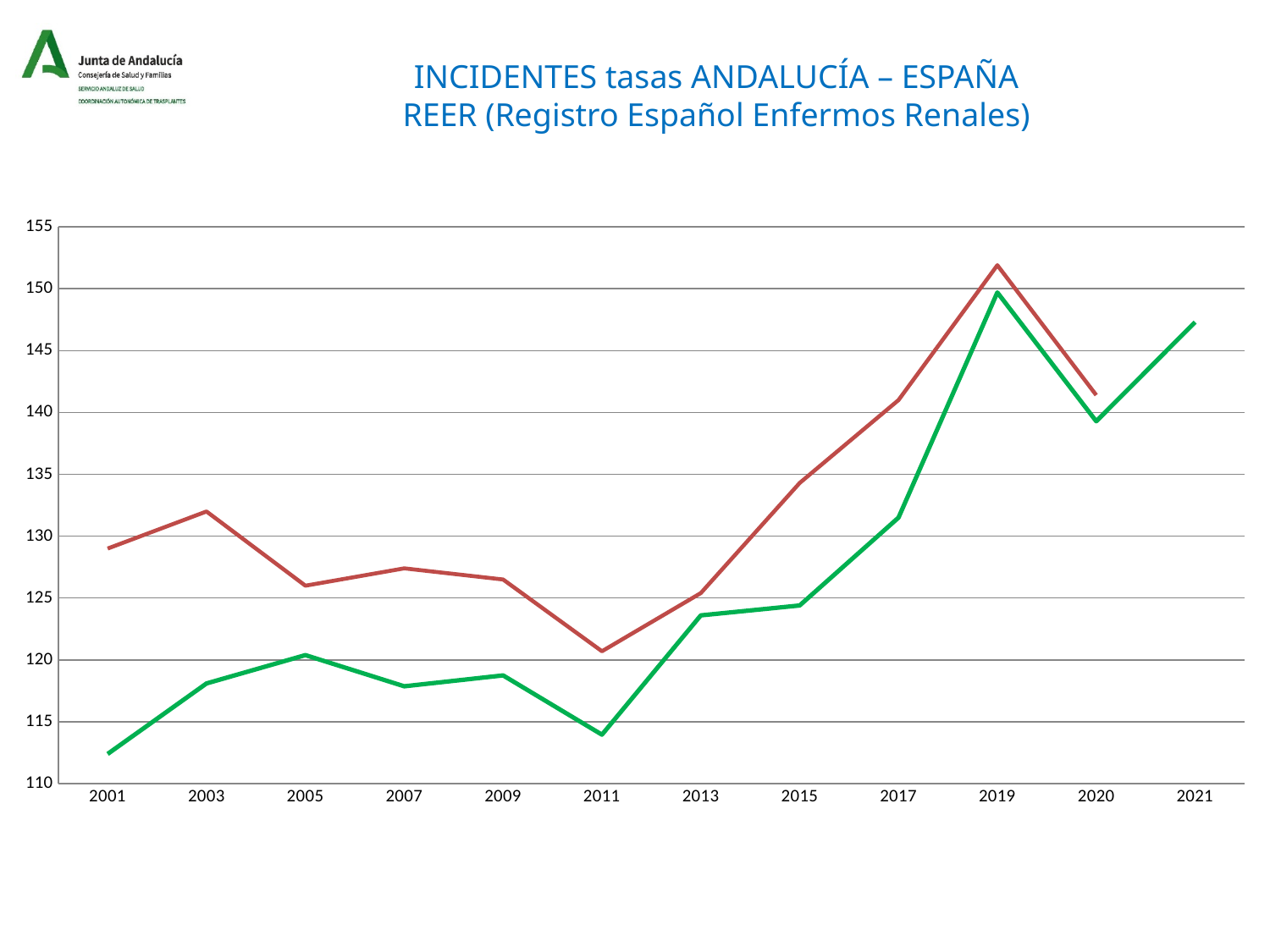
Is the value of the green line in 2001 greater or less than 115? less In which year does the red line reach its lowest value? 2011 Is the value of the green line in 2017 greater or less than 130? greater In which year does the red line reach its highest value? 2019 How many lines are plotted on the chart? 2 What kind of chart is shown on the slide? line chart Does the green line rise or fall between 2011 and 2019? rise What is the first line of the chart's title? INCIDENTES tasas ANDALUCÍA – ESPAÑA How many years are marked along the x axis of the chart? 12 In which year does the green line reach its lowest value? 2001 Which line has the higher value in 2001, the red line or the green line? the red line Is the value of the red line in 2019 greater or less than 150? greater